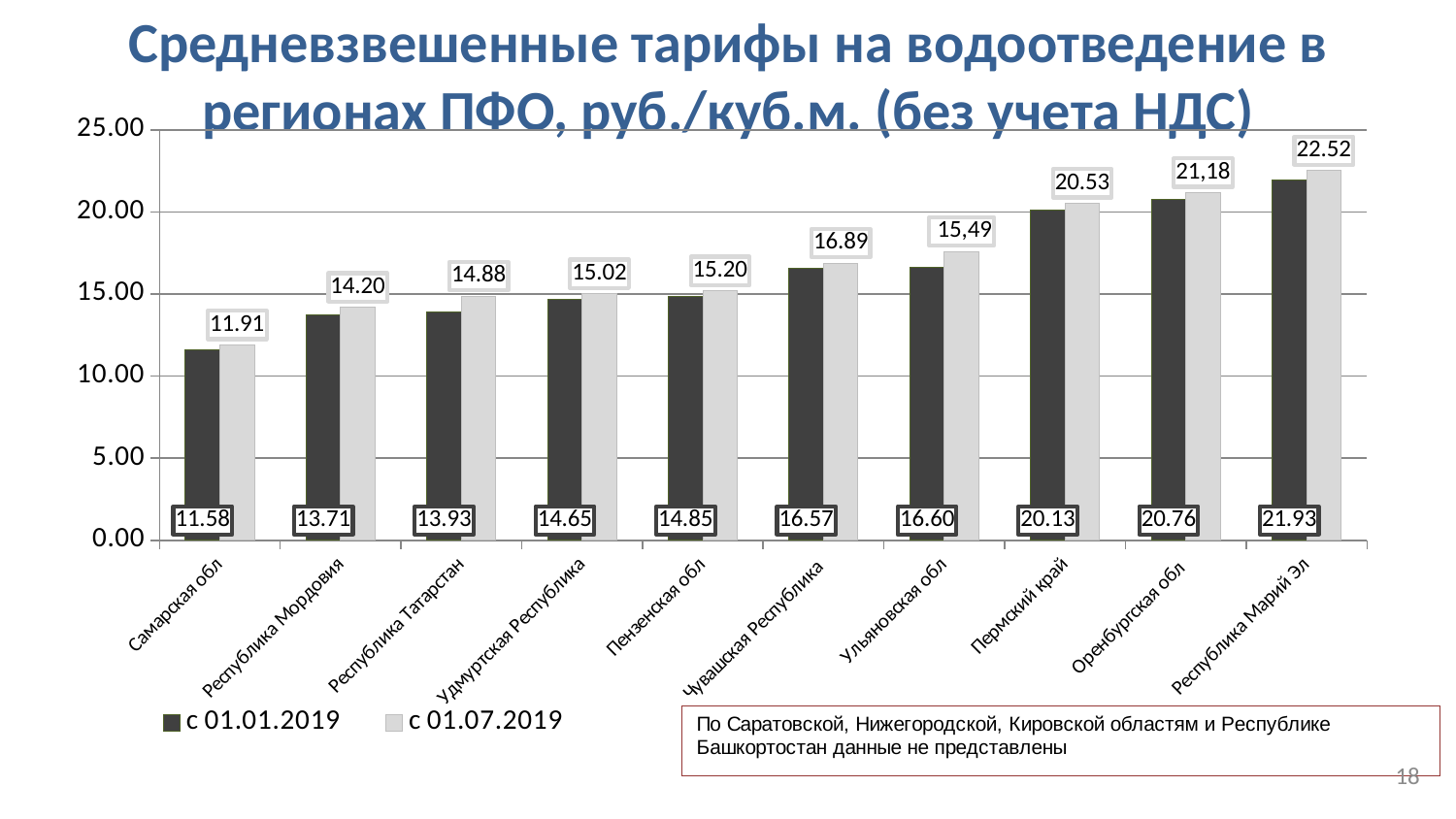
What is the difference between the 'с 01.07.2019' and 'с 01.01.2019' tariffs for Республика Татарстан? 0.95 What type of chart is shown on the slide? bar chart Which region has the highest tariff in the series 'с 01.01.2019'? Республика Марий Эл What is the tariff for Республика Марий Эл in the series 'с 01.07.2019'? 22,52 How many regions are shown on the x axis? 10 How many series does the legend list? 2 Which is larger: the 'с 01.01.2019' tariff for Оренбургская обл or for Пермский край? Оренбургская обл Which region has the lowest tariff in the series 'с 01.07.2019'? Самарская обл Do the 'с 01.01.2019' tariffs rise or fall from left to right along the x axis? rise Which series is shown with dark grey bars? с 01.01.2019 What is the tariff for Самарская обл in the series 'с 01.01.2019'? 11.58 What is the tariff for Пермский край in the series 'с 01.01.2019'? 20.13